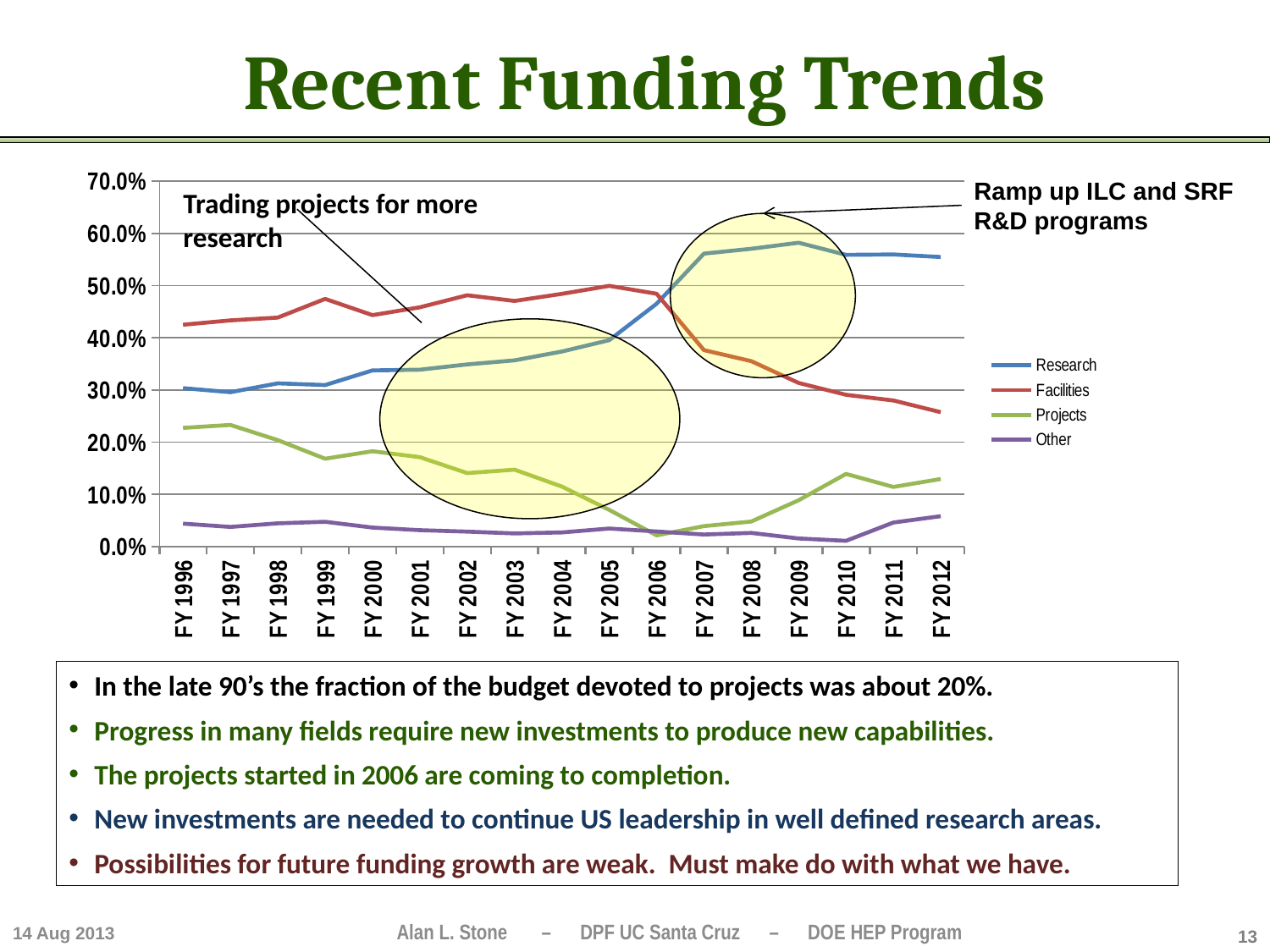
Is the Research value in FY 2012 greater or less than 50.0%? greater Which colour is used for the Facilities line? red Is the Projects value in FY 2006 greater or less than 10.0%? less Is the Facilities value in FY 2012 greater or less than 30.0%? less In FY 1996, which is larger, Projects or Other? Projects How many series does the chart legend list? 4 Which series has the lowest value in FY 1996? Other Which series has the highest value in FY 2012? Research What kind of chart is shown on the slide? line chart How many fiscal years are plotted along the x axis? 17 Which series has the highest value in FY 1996? Facilities Does the Research series rise or fall from FY 1996 to FY 2012? rise